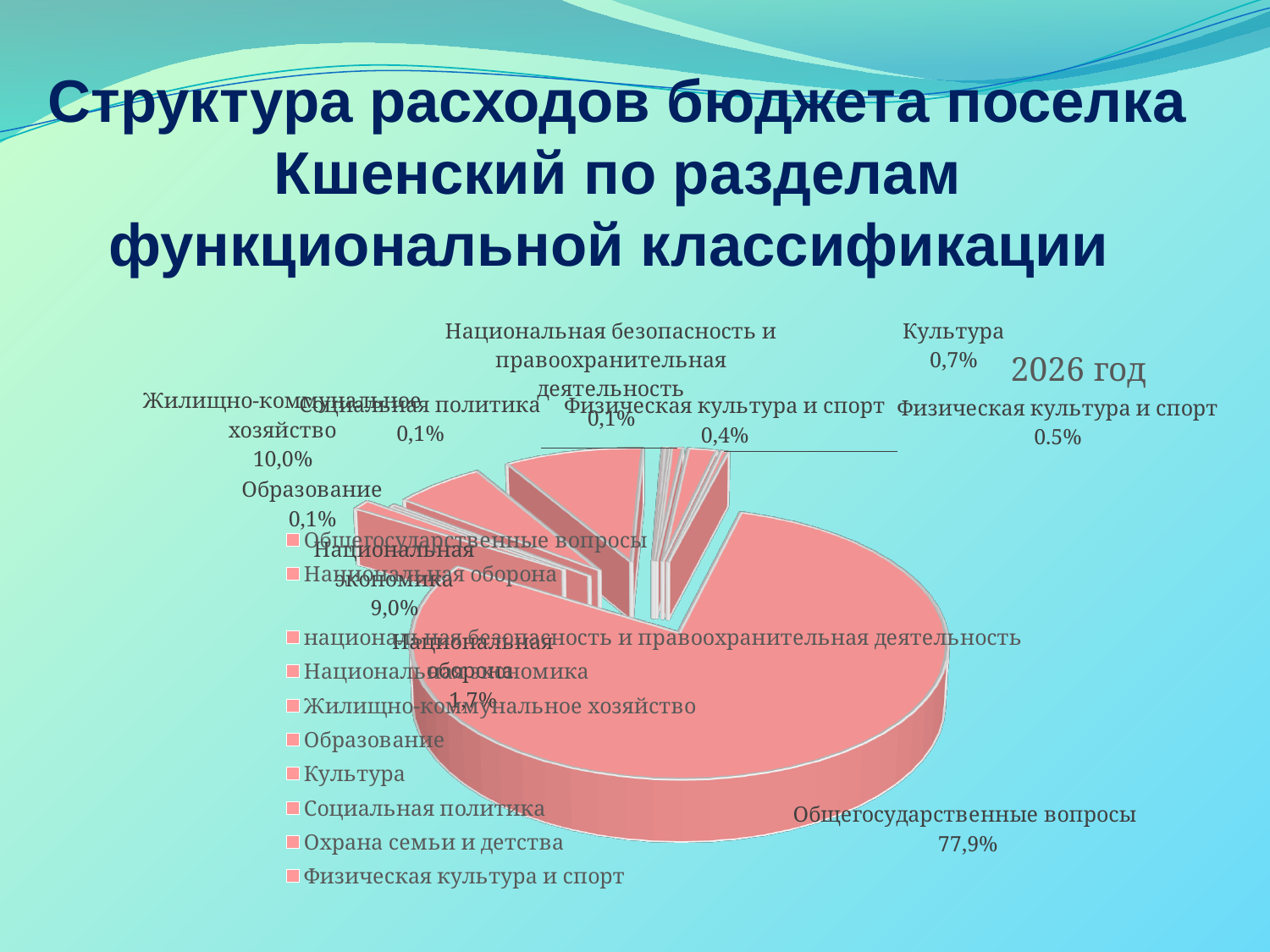
What is the difference between the shares of Общегосударственные вопросы and Жилищно-коммунальное хозяйство? 67,9% What is the value shown for Культура? 0,7% Which is larger: Жилищно-коммунальное хозяйство or Национальная экономика? Жилищно-коммунальное хозяйство How many entries does the chart legend list? 10 What is the difference between the shares of Жилищно-коммунальное хозяйство and Национальная экономика? 1,0% What is the value shown for Национальная оборона? 1,7% Which section has the largest share of the pie? Общегосударственные вопросы What share of the budget expenditure goes to Общегосударственные вопросы? 77,9% What kind of chart is shown on the slide? pie chart What is the value shown for Национальная экономика? 9,0% What year is shown as the chart's title? 2026 год What is the value shown for Жилищно-коммунальное хозяйство? 10,0%